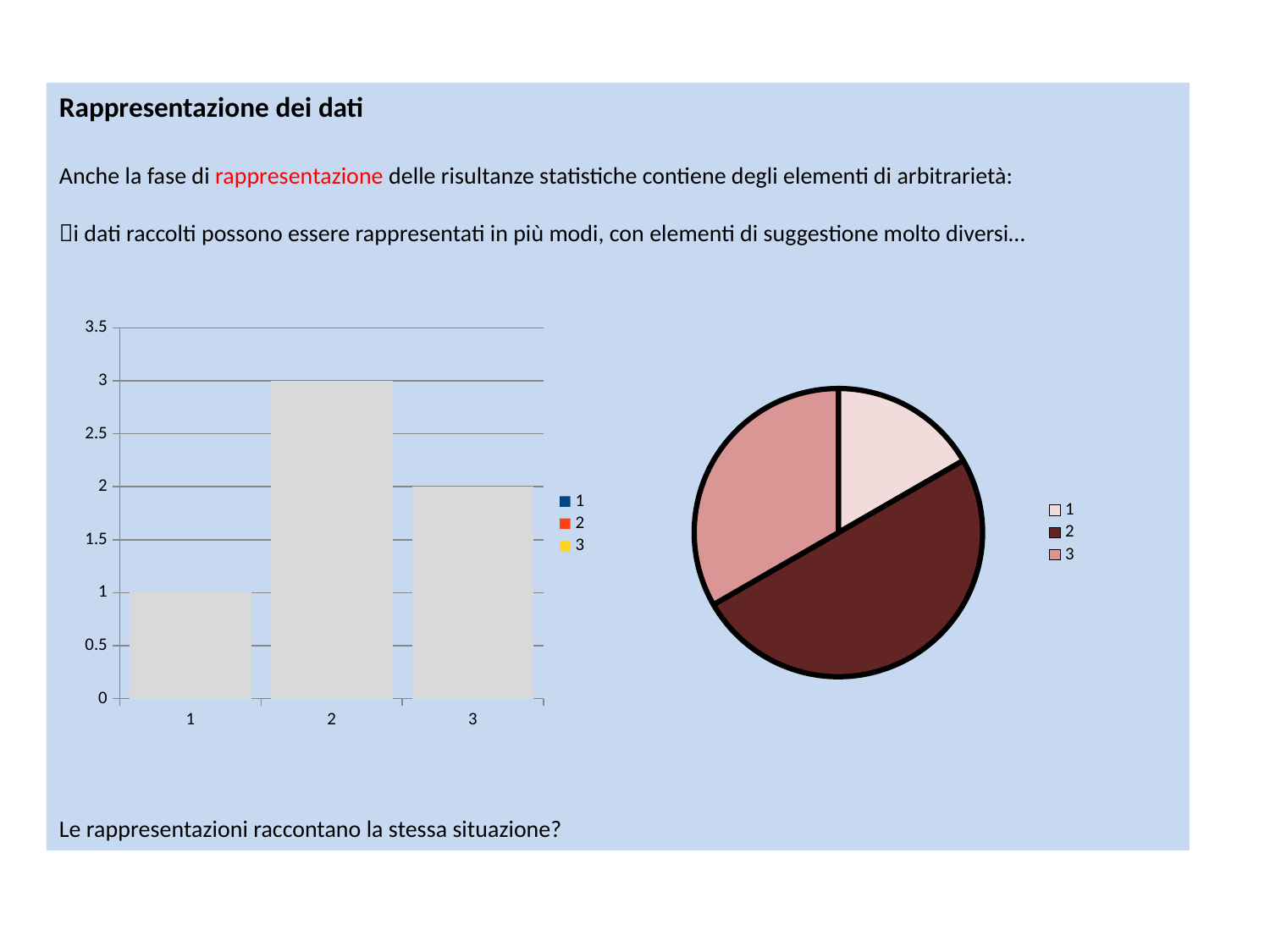
On the bar chart on the left, what is the difference between the values for category 2 and category 1? 2 On the pie chart on the right, how many entries does the legend list? 3 What kind of chart is shown on the left of the slide? bar chart On the bar chart on the left, what is the value for category 2? 3 On the bar chart on the left, which is larger, the value for category 3 or the value for category 1? category 3 On the bar chart on the left, which category has the highest value? 2 On the pie chart on the right, which slice is the largest? 2 On the bar chart on the left, what is the value for category 3? 2 What kind of chart is shown on the right of the slide? pie chart On the bar chart on the left, what is the value for category 1? 1 On the bar chart on the left, how many bars are plotted? 3 On the bar chart on the left, which category has the lowest value? 1